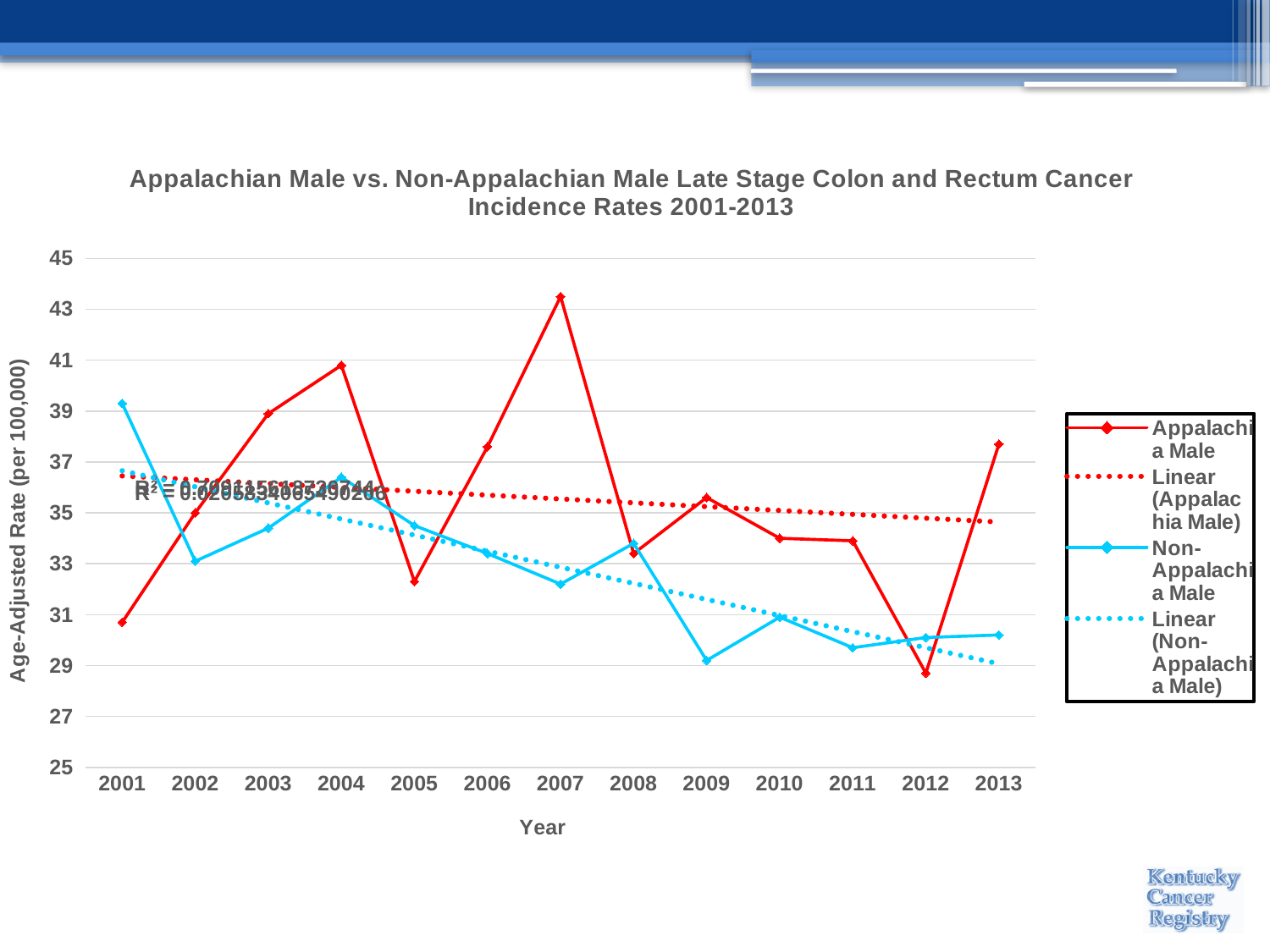
In 2007, which series has the higher value, Appalachian Male or Non-Appalachian Male? Appalachian Male How many years are plotted along the x axis? 13 In 2001, which series has the higher value, Appalachian Male or Non-Appalachian Male? Non-Appalachian Male In which year does the Appalachian Male series reach its lowest value? 2012 How many entries does the legend list? 4 Is the Appalachian Male value for 2007 greater or less than 41? greater Is the Non-Appalachian Male value for 2009 greater or less than 31? less What type of chart is shown on the slide? Line chart In which year does the Non-Appalachian Male series reach its highest value? 2001 In which year does the Appalachian Male series reach its highest value? 2007 Does the Non-Appalachian Male series generally rise or fall from 2001 to 2013? Fall Is the Appalachian Male value for 2012 greater or less than 29? less